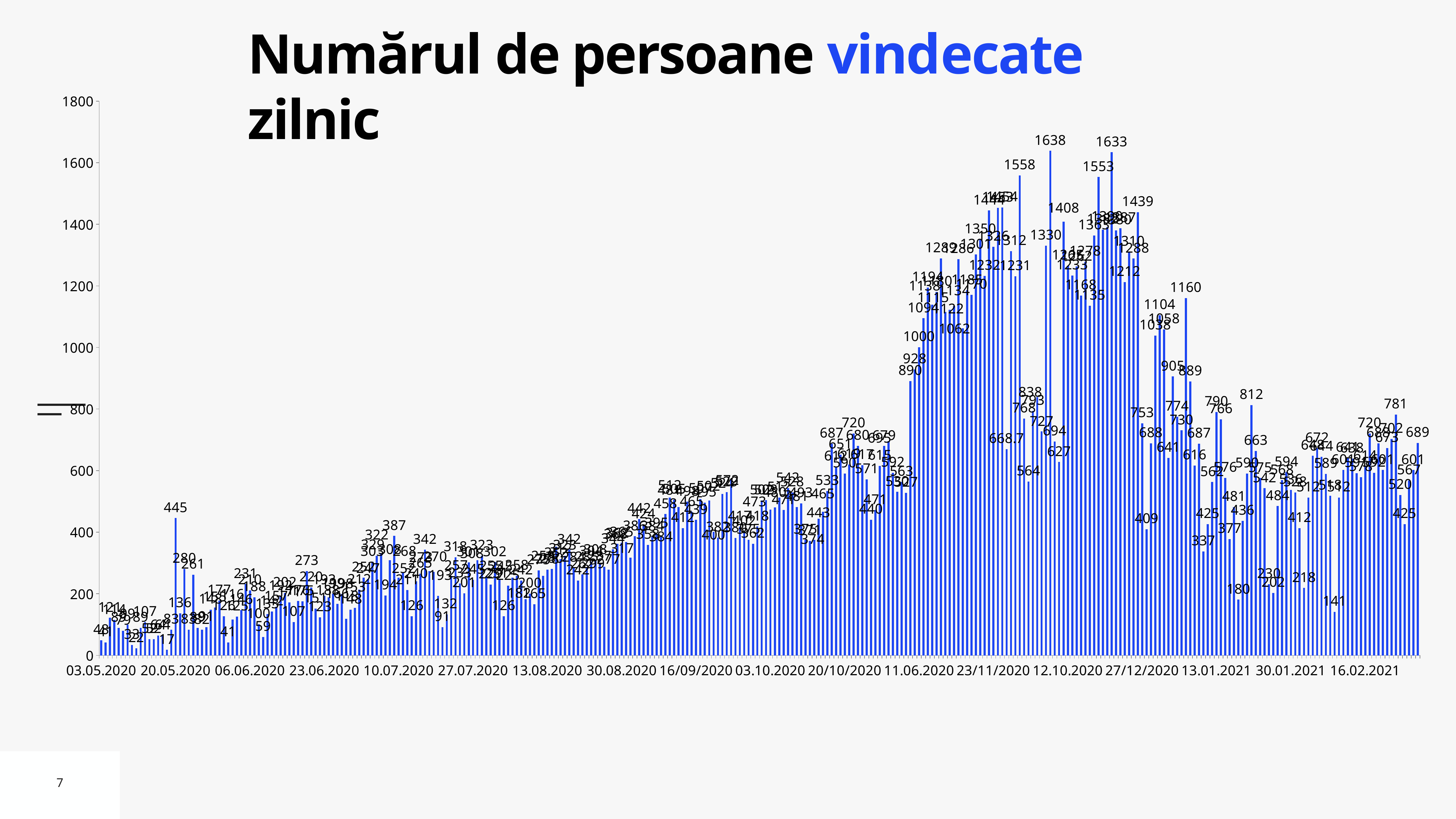
What is the difference between the two highest labelled values, 1638 and 1633? 5 Do the daily values generally rise or fall from May 2020 to November 2020? rise What is the difference between the highest labelled value (1638) and the labelled value 1558? 80 What is the title of the chart? Numărul de persoane vindecate zilnic What is the lowest daily value labelled on the chart? 17 What is the value of the tallest bar in the May 2020 section of the chart (near 20.05.2020)? 445 What is the highest daily value labelled on the chart? 1638 What is the highest value shown on the vertical axis? 1800 Is the highest bar on the chart greater or less than 1600? greater What kind of chart is shown on the slide? bar chart Which is larger: the bar labelled 1638 or the bar labelled 1160? 1638 What is the value of the last (rightmost) bar on the chart? 689